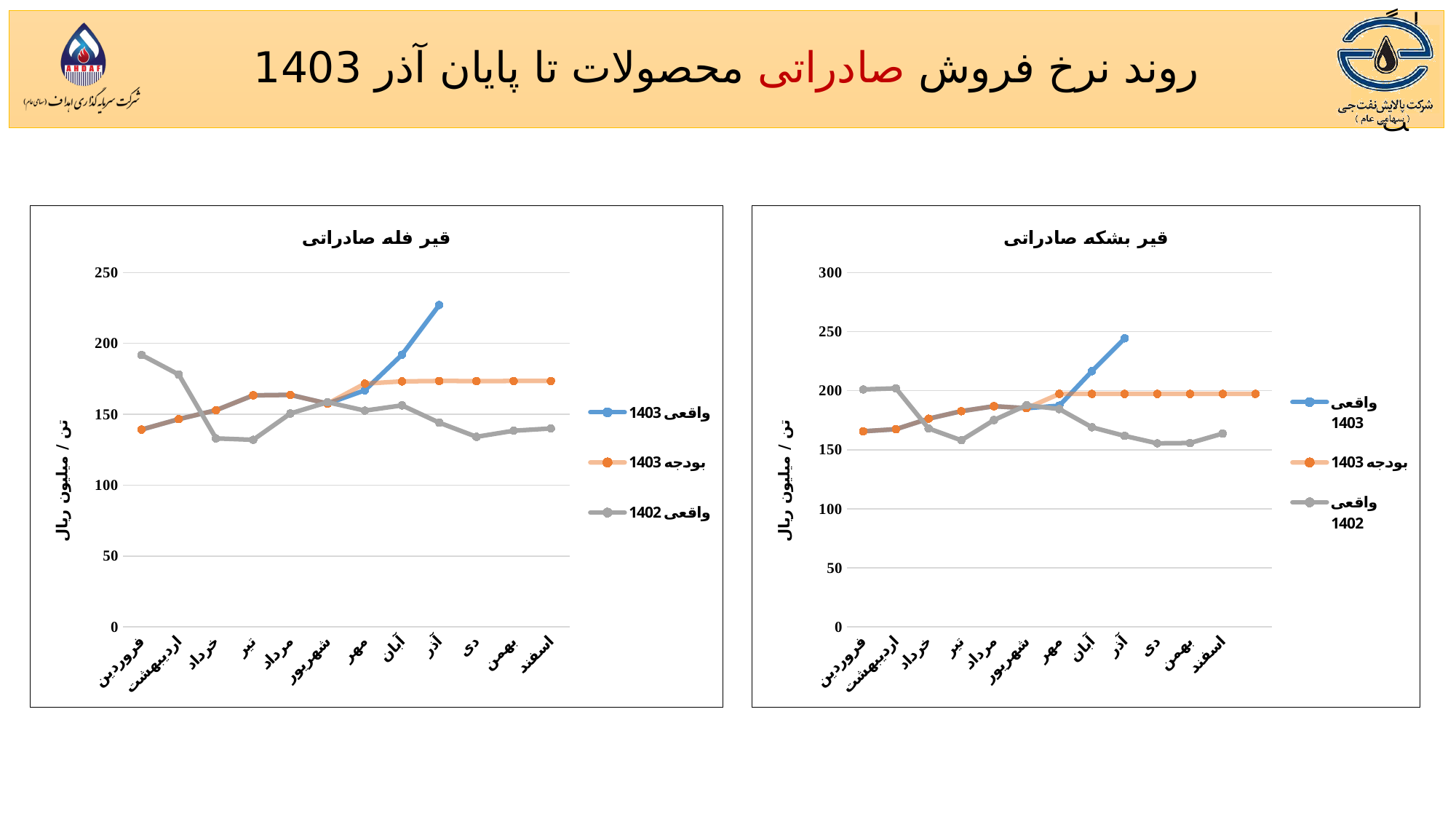
In the left chart "قیر فله صادراتی", which is larger in آذر: واقعی 1403 or بودجه 1403? واقعی 1403 How many months are shown on the x axis of the left chart "قیر فله صادراتی"? 12 In the left chart "قیر فله صادراتی", is the value of واقعی 1402 in فروردین greater or less than 150? greater How many series does the legend of the left chart "قیر فله صادراتی" list? 3 What kind of chart is the left chart titled "قیر فله صادراتی"? line chart In the left chart "قیر فله صادراتی", which month has the highest value for واقعی 1402? فروردین What is the y-axis label of the right chart "قیر بشکه صادراتی"? تن / میلیون ریال In the left chart "قیر فله صادراتی", is the value of واقعی 1403 in آذر greater or less than 200? greater In the right chart "قیر بشکه صادراتی", is the value of واقعی 1403 in آذر greater or less than 200? greater What kind of chart is the right chart titled "قیر بشکه صادراتی"? line chart In the left chart "قیر فله صادراتی", does the واقعی 1403 line rise or fall from مهر to آذر? rise